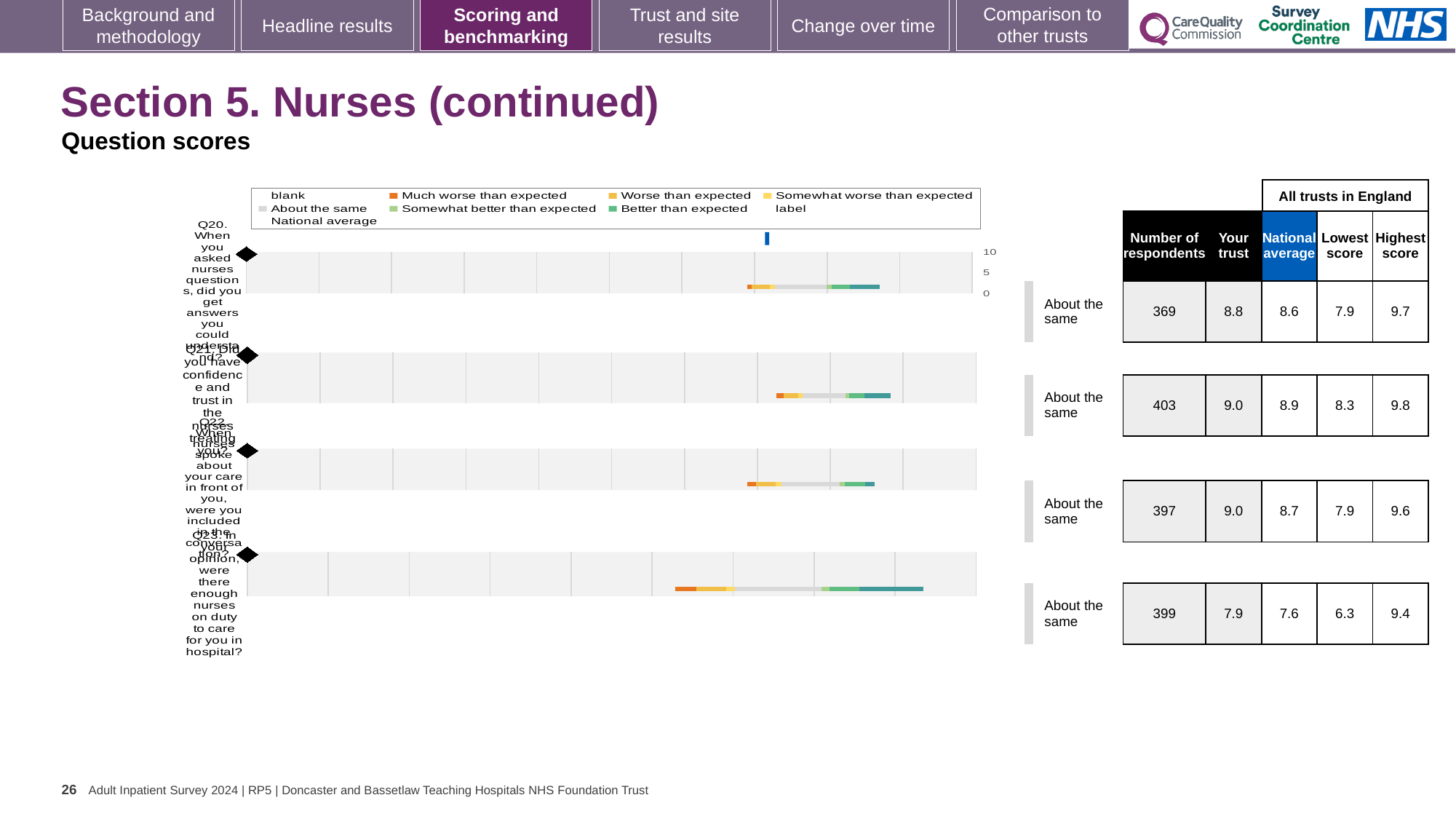
What kind of chart is used to show the question scores for Q20 to Q23? bar chart What is the 'Your trust' score for Q23 (were there enough nurses on duty)? 7.9 What benchmark category is shown for Q23? About the same What is the highest score among all trusts in England for Q23? 9.4 How many questions (Q20 to Q23) have a chart on this slide? 4 For Q22, which is larger: the 'Your trust' score or the national average? Your trust What is the difference between the highest score and the lowest score for Q21? 1.5 Which question has the lowest 'Your trust' score? Q23 How many respondents answered Q21? 403 What is the lowest score among all trusts in England for Q20? 7.9 What is the national average score for Q21 (confidence and trust in the nurses)? 8.9 What is the difference between the 'Your trust' score and the national average for Q20? 0.2